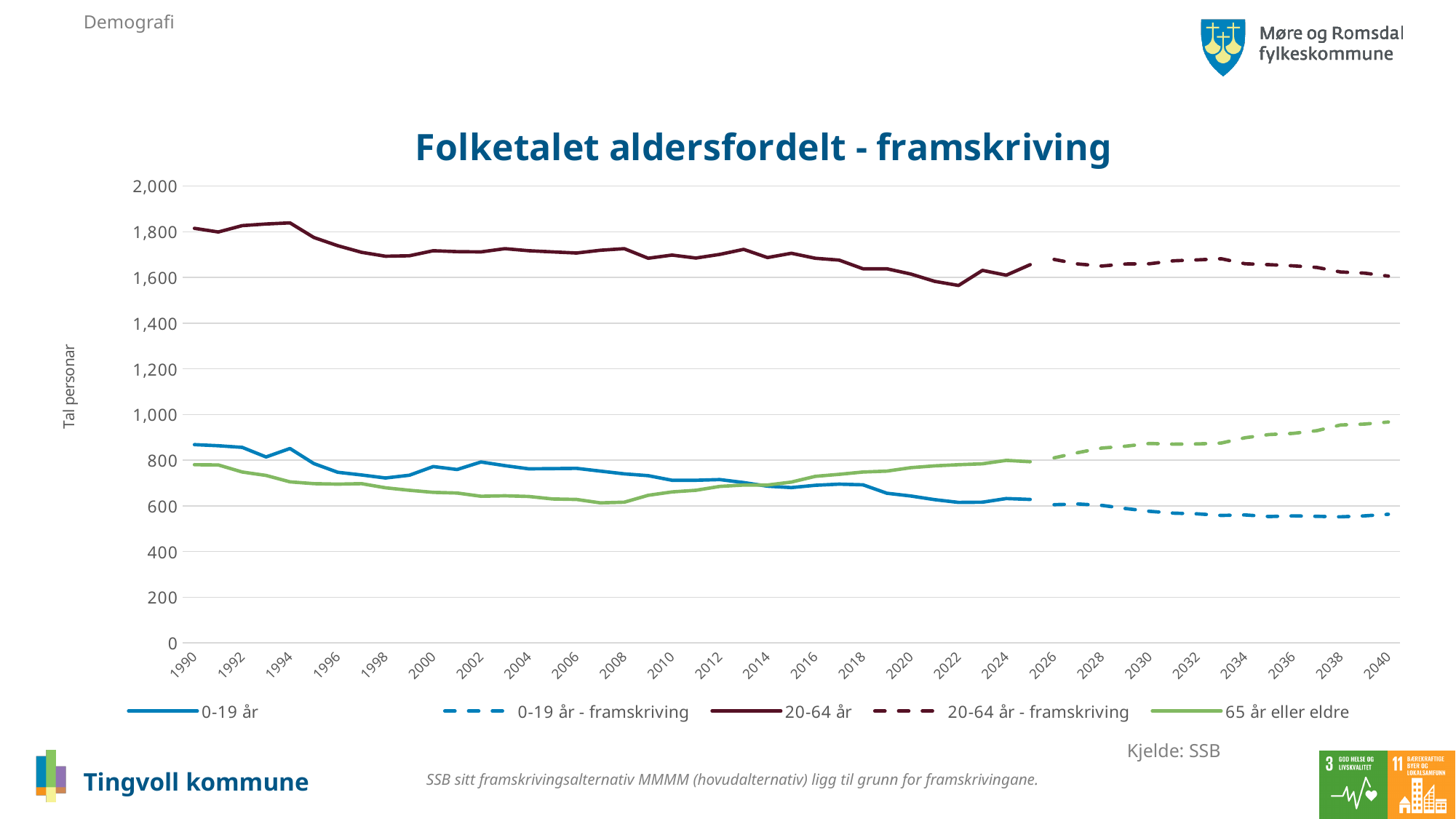
Is the value for 20-64 år in 1990 greater or less than 1,600? greater In 2040, which series has the higher value: 65 år eller eldre or 0-19 år - framskriving? 65 år eller eldre In 1990, which series has the higher value: 0-19 år or 65 år eller eldre? 0-19 år Is the value for 0-19 år - framskriving in 2040 greater or less than 600? less Is the value for 65 år eller eldre in 2040 greater or less than 800? greater Which series has the highest values across the whole period? 20-64 år Does the 65 år eller eldre series rise or fall from 2014 to 2040? rise Does the 0-19 år series rise or fall overall from 1990 to 2024? fall What kind of chart is shown on the slide? line chart How many series does the legend list? 5 What is the title of the chart? Folketalet aldersfordelt - framskriving